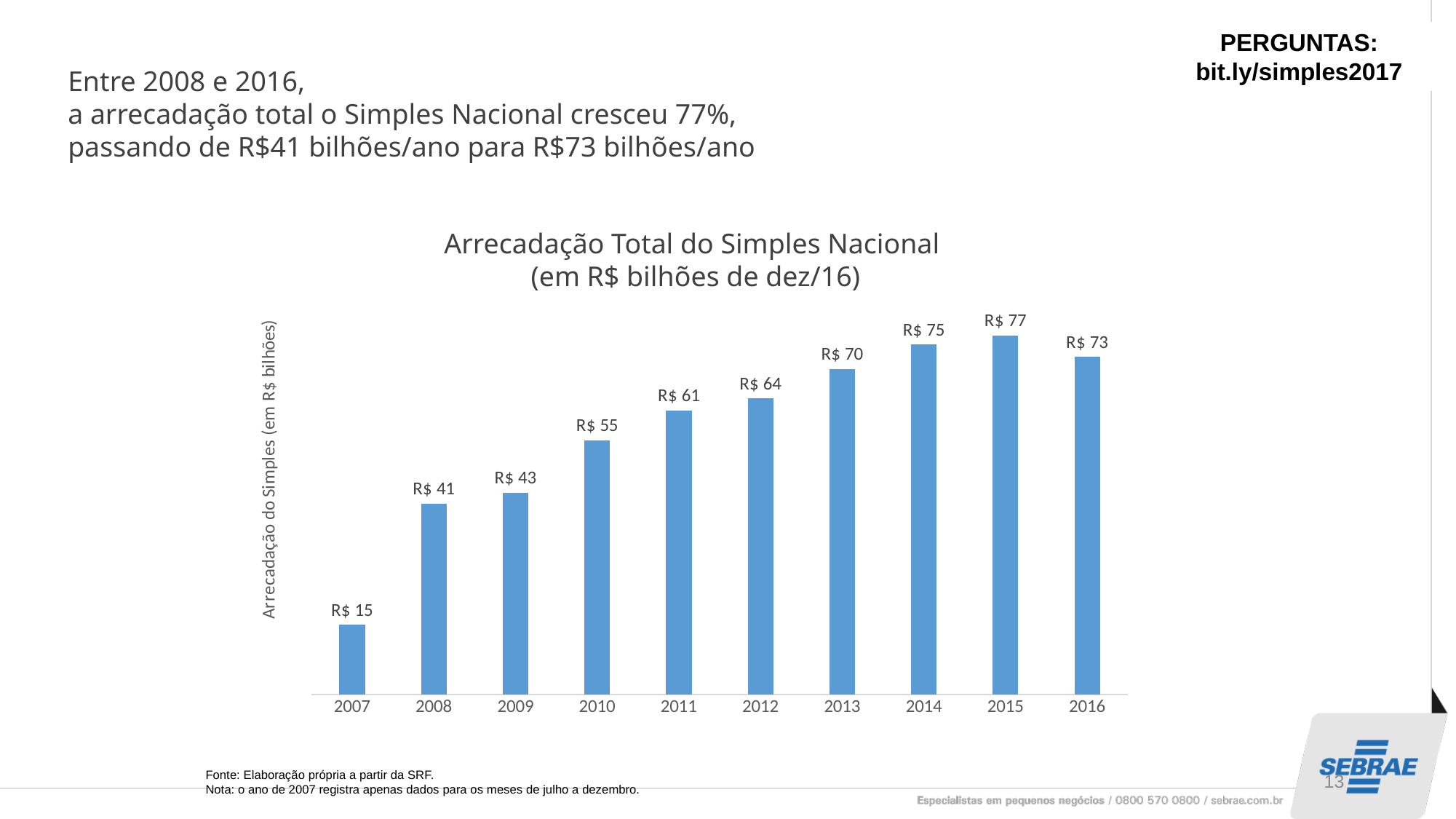
How many years are shown on the x axis of the chart? 10 Do the values generally rise or fall from 2007 to 2015? Rise What is the value for 2016 in the chart? R$ 73 What is the difference between the values for 2015 and 2014? R$ 2 What is the value for 2010 in the chart? R$ 55 What is the difference between the values for 2016 and 2008? R$ 32 What is the title of the chart? Arrecadação Total do Simples Nacional (em R$ bilhões de dez/16) Which year has the highest value in the chart? 2015 Which year has the lowest value in the chart? 2007 What is the value for 2007 in the chart? R$ 15 What kind of chart is shown on the slide? Bar chart Which is larger, the value for 2013 or the value for 2012? 2013